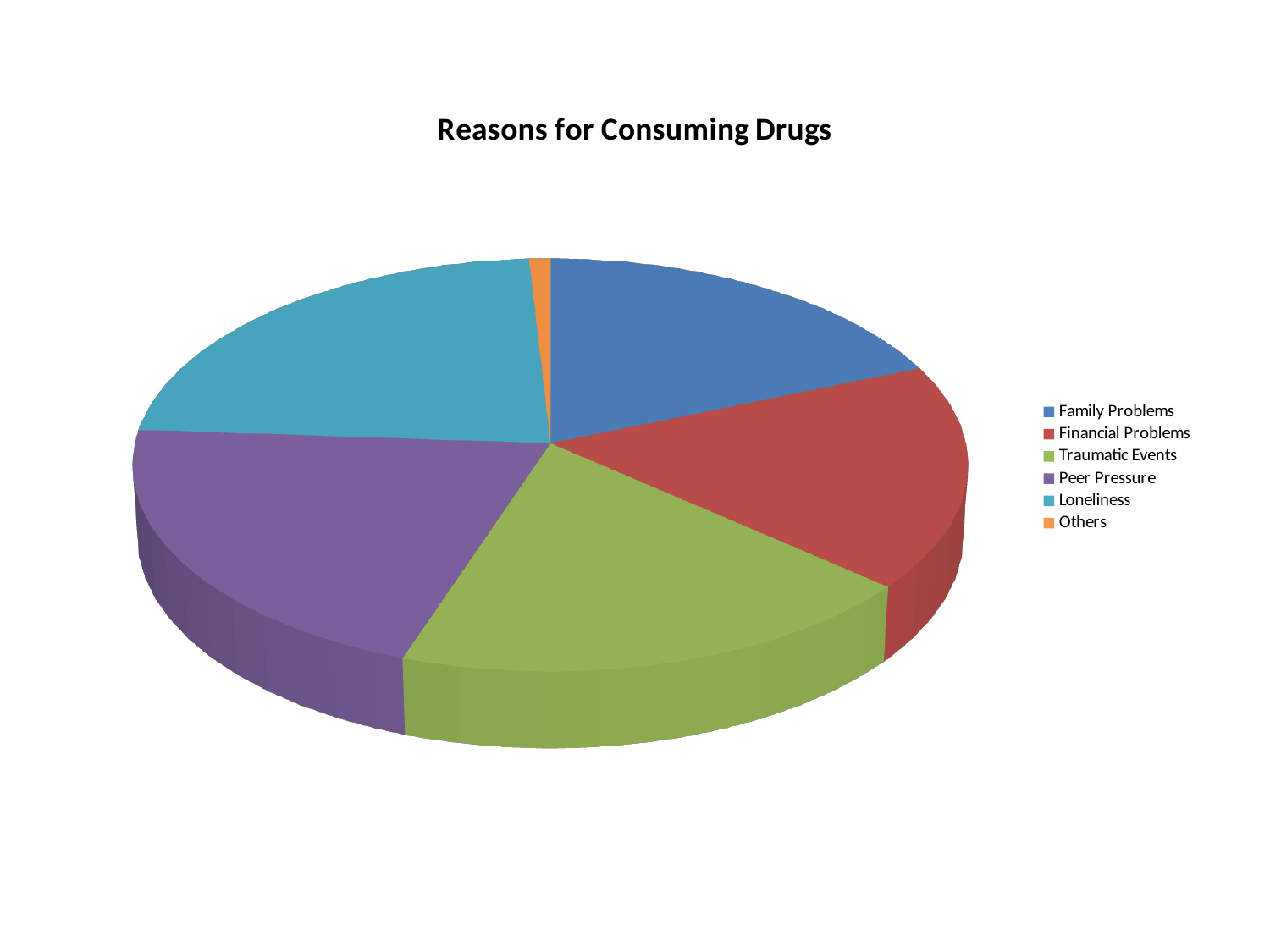
What kind of chart is shown on the slide? pie chart How many categories does the pie chart have? 6 Which slice is larger, Traumatic Events or Others? Traumatic Events How many entries does the legend list? 6 What is the title of the chart? Reasons for Consuming Drugs Which category has the smallest slice of the pie? Others Which slice is larger, Others or Loneliness? Loneliness Which category is shown in orange in the legend? Others Which slice is larger, Traumatic Events or Financial Problems? Traumatic Events